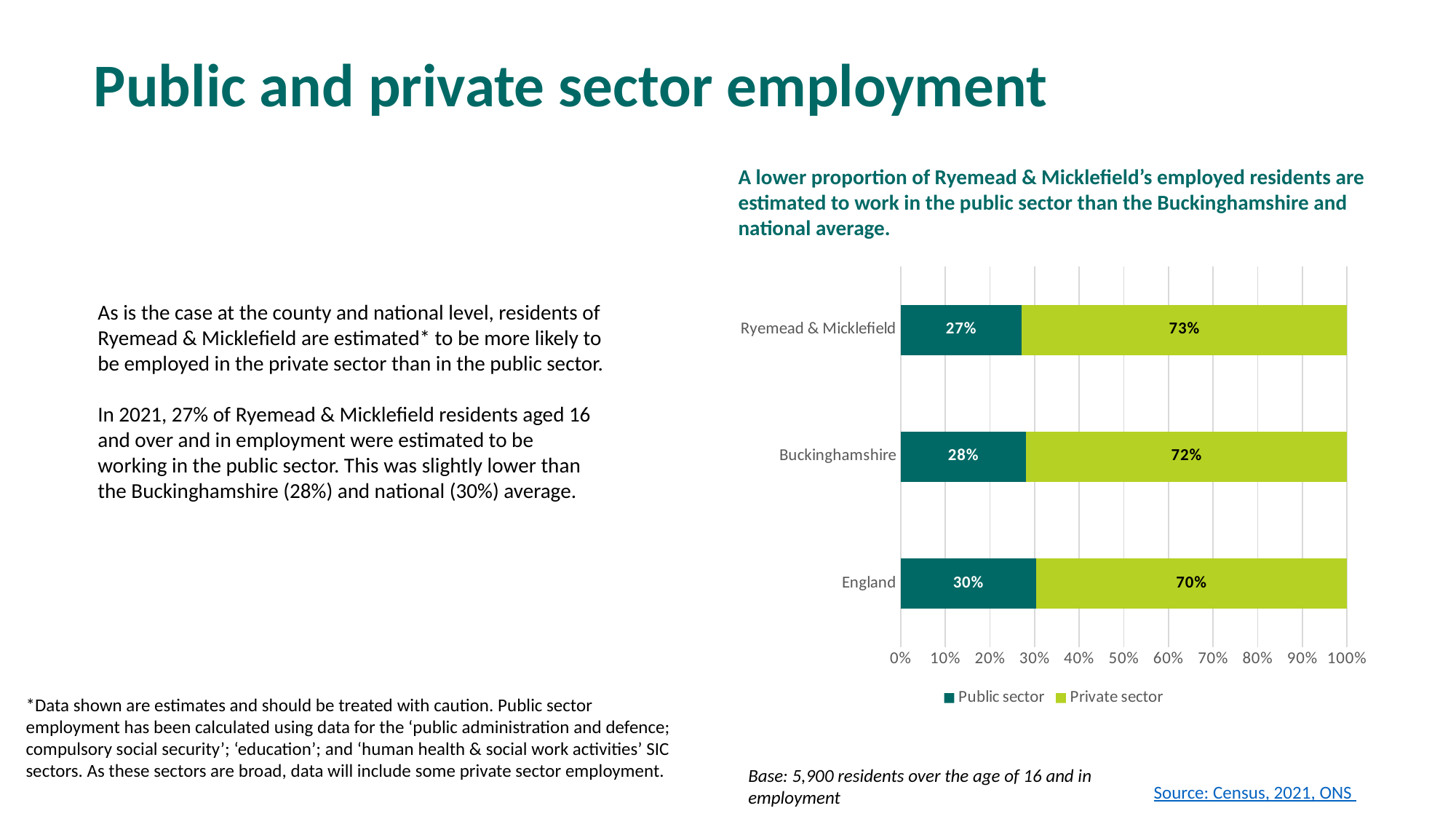
Which colour represents the public sector in the chart? Dark teal What is the private sector share for Buckinghamshire? 72% Which area has the lowest public sector share? Ryemead & Micklefield Which area has the highest public sector share? England What is the difference in percentage points between the public sector share in England and in Ryemead & Micklefield? 3 percentage points Which is larger: the private sector share for Ryemead & Micklefield or for England? Ryemead & Micklefield How many areas are shown on the chart? 3 What type of chart is shown on the slide? Stacked bar chart What is the public sector value for England? 30% What is the total of the stacked bar for Buckinghamshire? 100% How many series does the legend list? 2 What percentage of Ryemead & Micklefield's employed residents work in the public sector? 27%